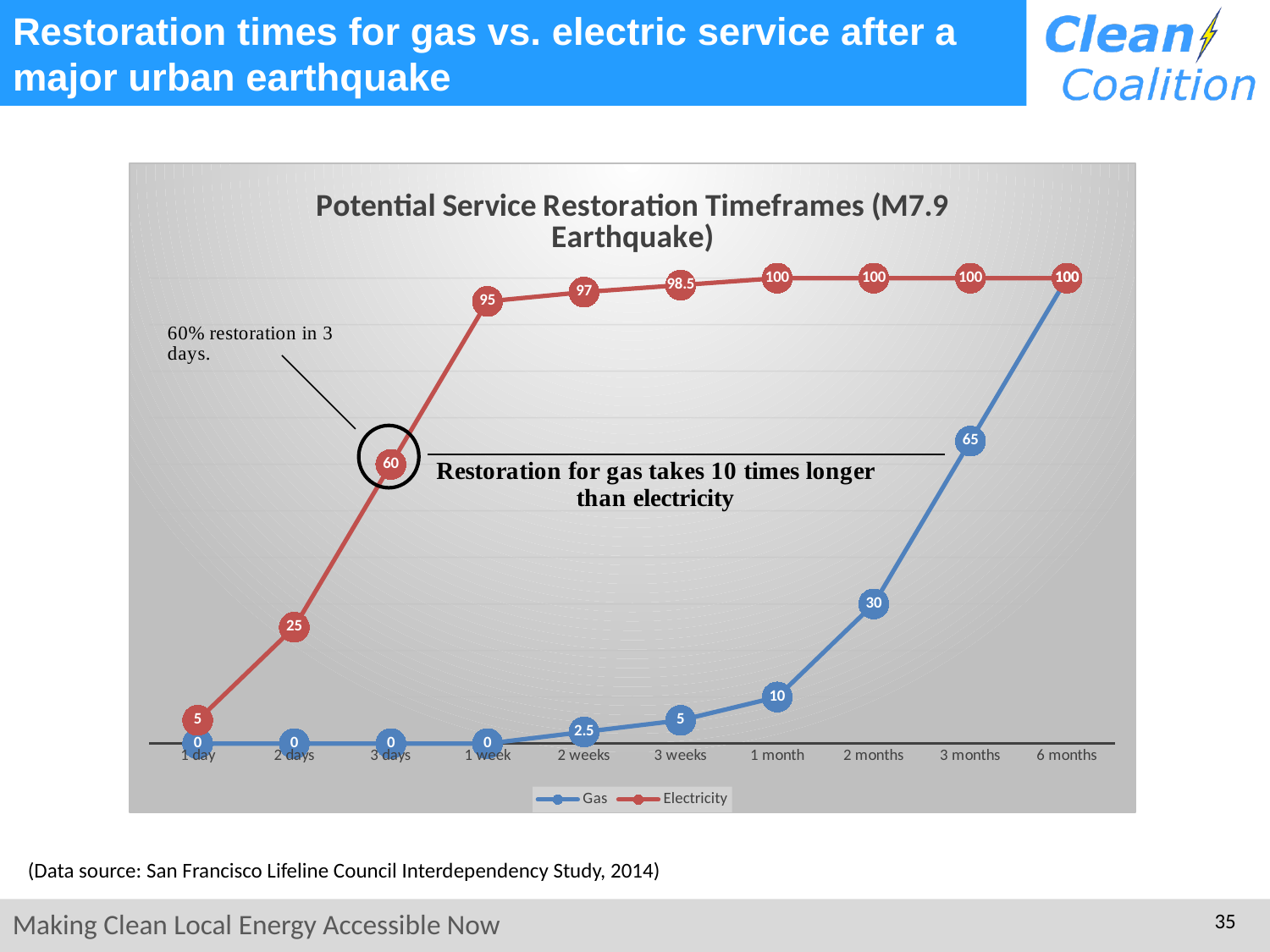
At which time point does the Gas series reach its highest value? 6 months What type of chart is shown on the slide? line chart Which series has the higher value at 1 week, Gas or Electricity? Electricity What is the title of the chart? Potential Service Restoration Timeframes (M7.9 Earthquake) What is the Gas value at 2 weeks? 2.5 What is the Electricity value at 3 weeks? 98.5 How many series does the legend list? 2 What is the difference between the Electricity and Gas values at 2 months? 70 Does the Gas series rise or fall from 1 week to 6 months? rise How many time categories are shown on the x axis? 10 What is the Electricity value at 3 days? 60 What is the Gas value at 3 months? 65